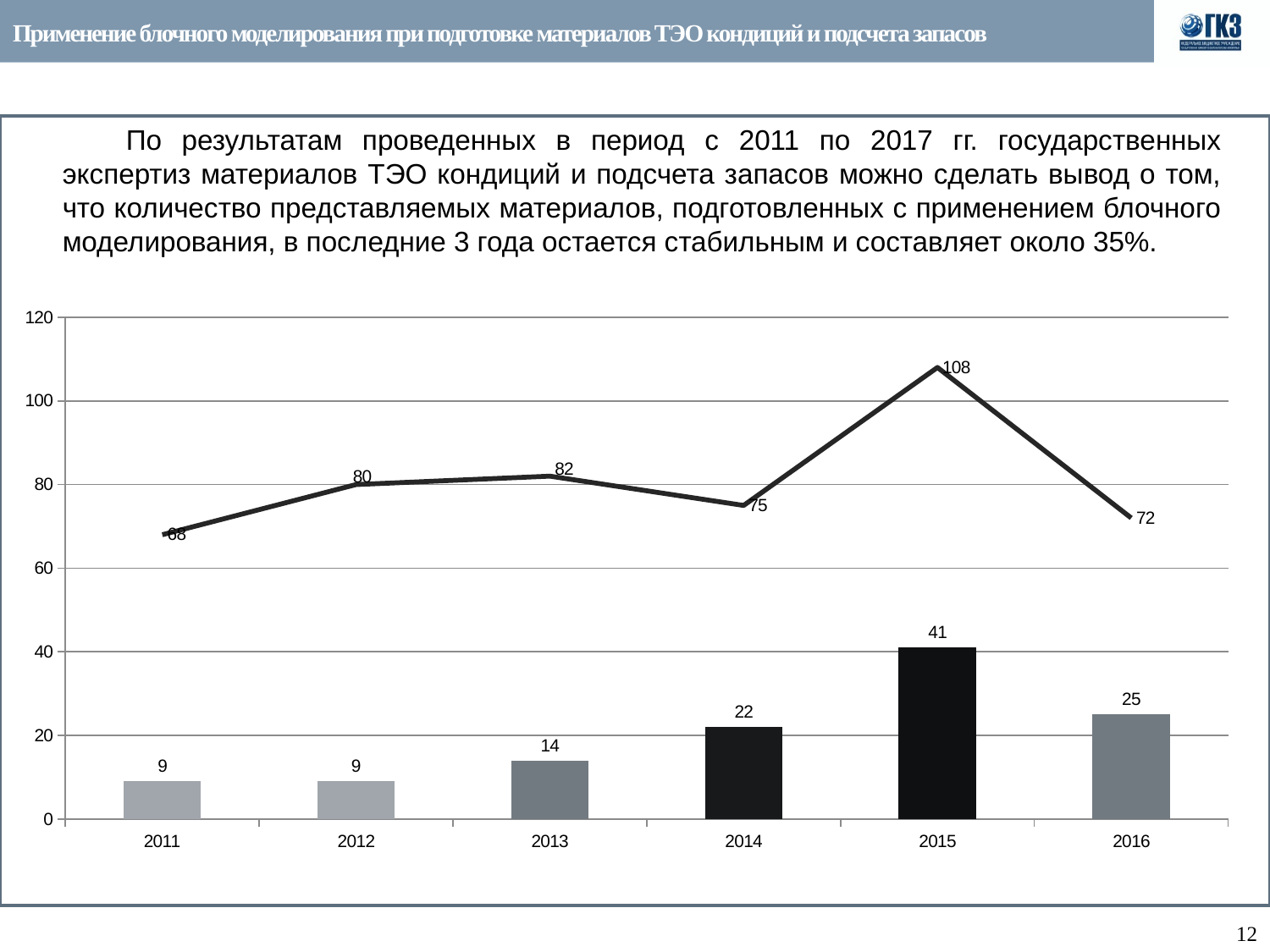
In which year does the line reach its highest value? 2015 What is the value of the bar for 2014? 22 What is the value of the line at 2013? 82 Does the bar value rise or fall from 2015 to 2016? fall What is the difference between the bar values for 2015 and 2016? 16 Which is larger, the bar value for 2013 or the bar value for 2014? 2014 How many years are shown on the x axis? 6 What is the difference between the line values for 2015 and 2014? 33 Which year has the lowest line value? 2011 What is the value of the bar for 2015? 41 What is the highest value shown on the vertical axis? 120 In which year is the bar the highest? 2015